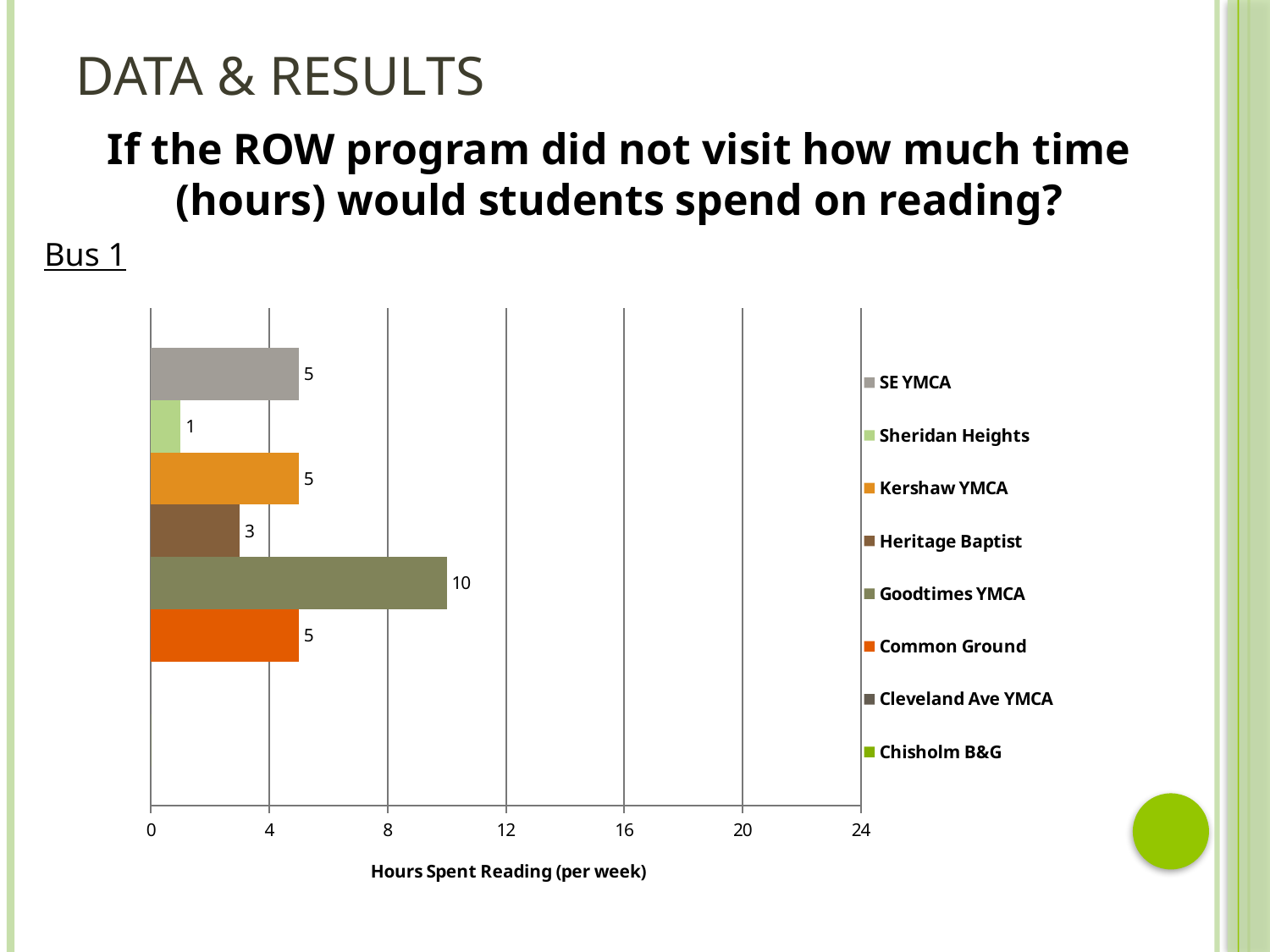
What is the value for Heritage Baptist? 3 How many series does the legend list? 8 What is the value for Sheridan Heights? 1 What is the value for Goodtimes YMCA? 10 Which is larger, the value for Common Ground or the value for Heritage Baptist? Common Ground What is the value for Kershaw YMCA? 5 What is the title of the horizontal axis? Hours Spent Reading (per week) Is the value for Goodtimes YMCA greater or less than 8? greater What kind of chart is shown on the slide? bar chart Which series has the highest value? Goodtimes YMCA What is the difference between the values for SE YMCA and Sheridan Heights? 4 What is the difference between the values for Goodtimes YMCA and Heritage Baptist? 7